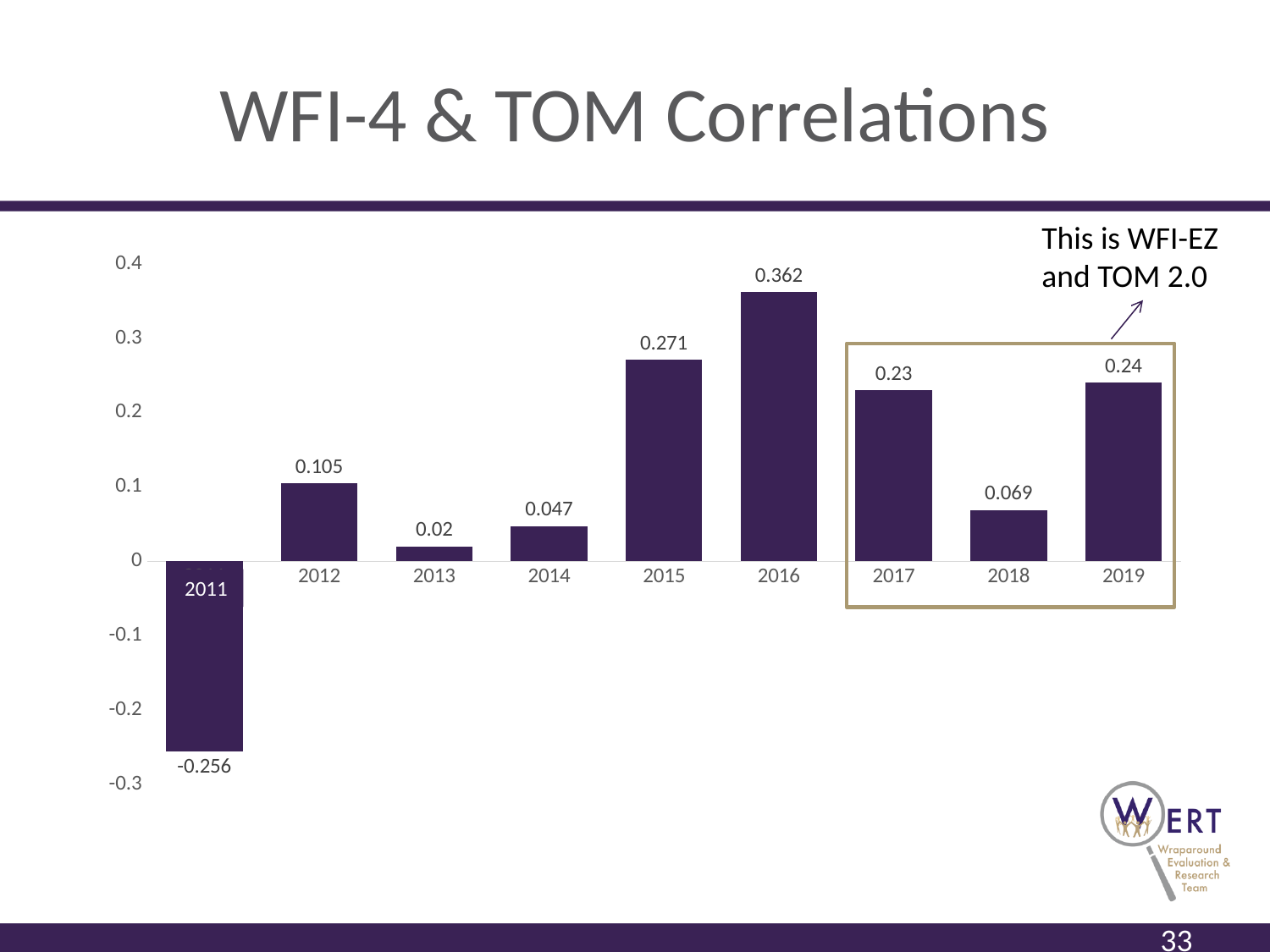
What is the difference between the values for 2016 and 2015? 0.091 How many years are shown on the x axis? 9 Which year has the lowest value? 2011 Do the values rise or fall from 2013 to 2016? rise Is the value for 2015 greater or less than 0.2? greater What is the value for 2016? 0.362 What kind of chart is shown on the slide? bar chart What is the value for 2011? -0.256 What is the title of the chart on the slide? WFI-4 & TOM Correlations Which year has the highest value? 2016 What is the value for 2018? 0.069 Which is larger, the value for 2017 or the value for 2019? 2019